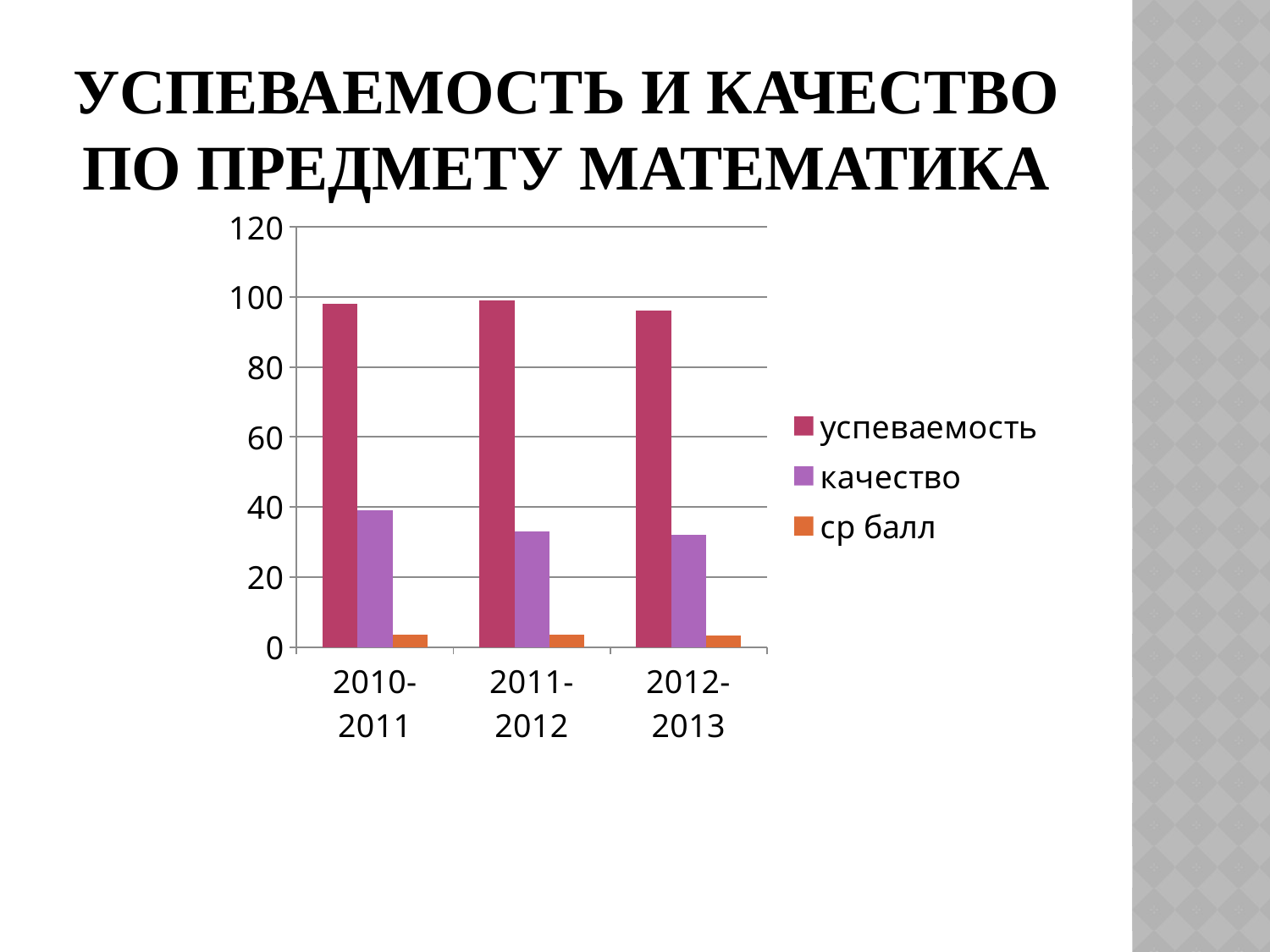
Is the value for качество in 2011-2012 greater or less than 40? less Is the value for ср балл in 2012-2013 greater or less than 20? less What kind of chart is shown on the slide? bar chart Which is larger: качество in 2010-2011 or качество in 2012-2013? качество in 2010-2011 Is the value for качество in 2010-2011 greater or less than 20? greater How many school-year categories are shown on the x axis? 3 In which school year is качество highest? 2010-2011 How many series does the legend list? 3 Does качество rise or fall from 2010-2011 to 2012-2013? fall Which series does the legend list first? успеваемость Which series is shown in orange? ср балл